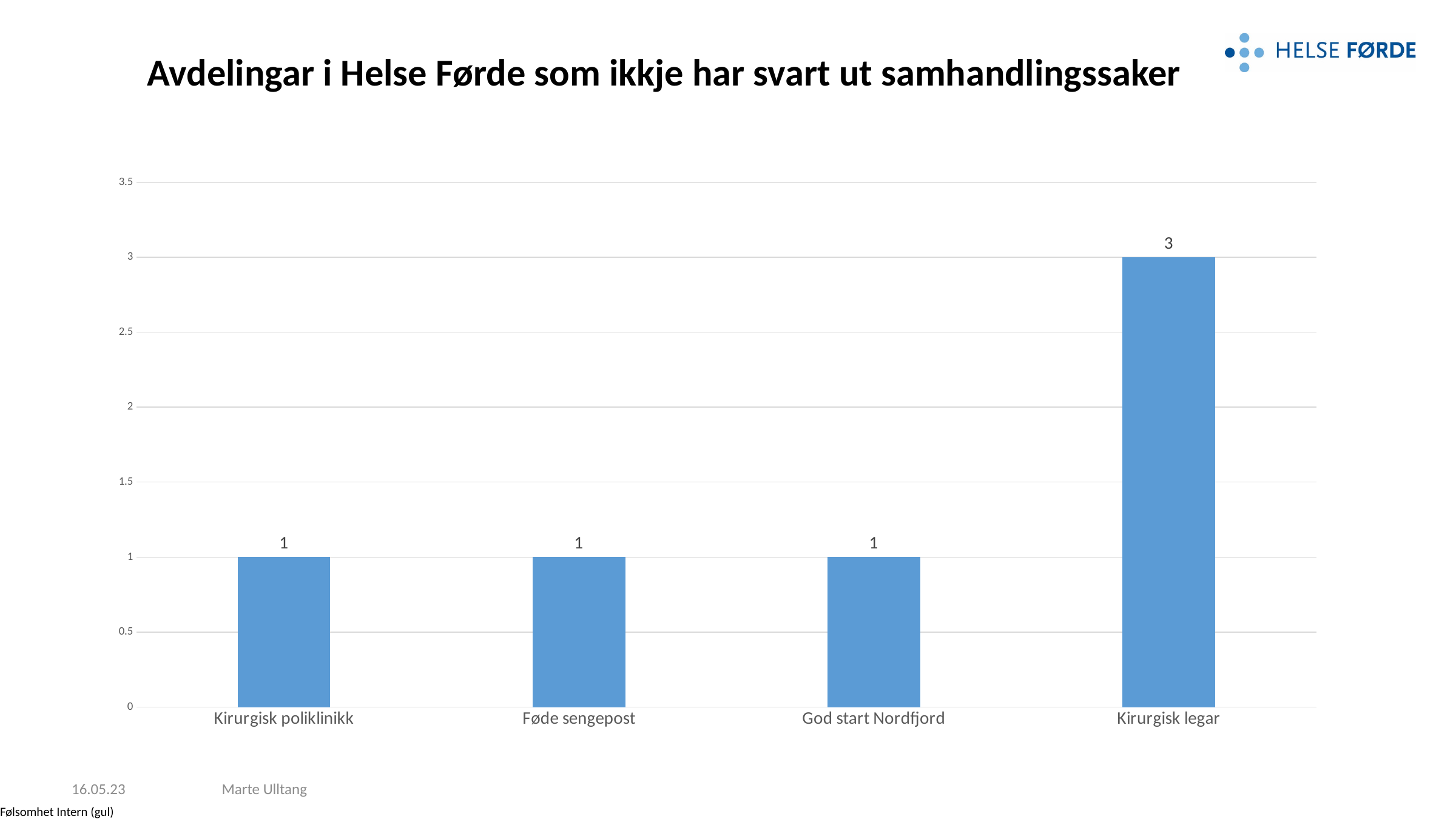
What kind of chart is shown on the slide? bar chart What is the value for God start Nordfjord? 1 What is the value for Kirurgisk legar? 3 Is the value for Kirurgisk legar greater or less than 2? greater How many categories are shown on the x axis? 4 What is the value for Kirurgisk poliklinikk? 1 What is the title of the slide? Avdelingar i Helse Førde som ikkje har svart ut samhandlingssaker Which category has the highest value? Kirurgisk legar Which is larger, the value for Kirurgisk legar or the value for Føde sengepost? Kirurgisk legar What is the difference between the values for Kirurgisk legar and God start Nordfjord? 2 What is the value for Føde sengepost? 1 What is the total of all four bars? 6